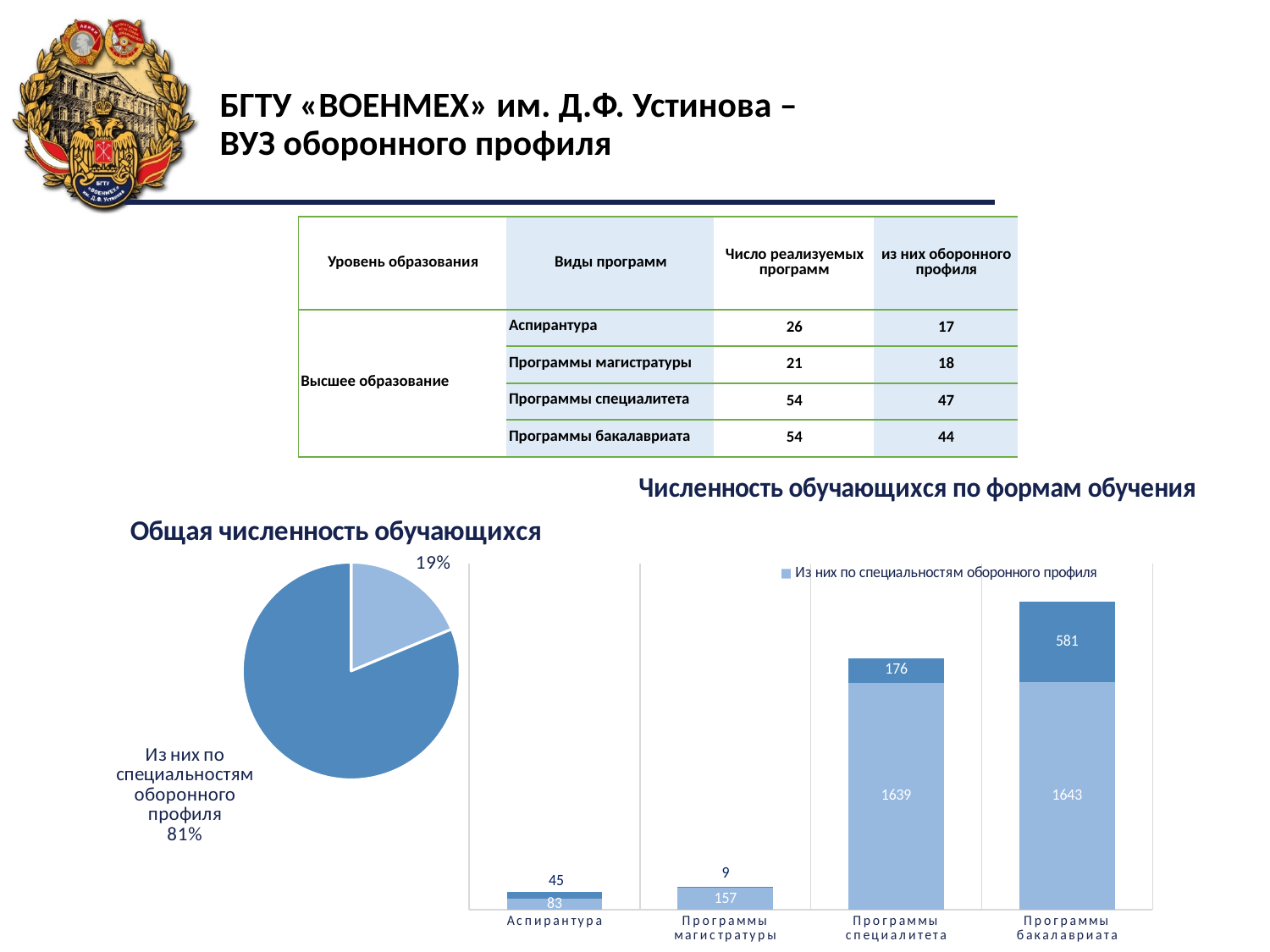
In the chart titled «Численность обучающихся по формам обучения», which category has the shortest stacked bar? Аспирантура In the chart titled «Численность обучающихся по формам обучения», what is the total of the stacked bar for Программы бакалавриата? 2224 In the chart titled «Численность обучающихся по формам обучения», which category has the tallest stacked bar? Программы бакалавриата In the chart titled «Численность обучающихся по формам обучения», what is the value of the dark-blue segment for Программы магистратуры? 9 In the chart titled «Численность обучающихся по формам обучения», what is the total of the stacked bar for Аспирантура? 128 In the pie chart titled «Общая численность обучающихся», what share is labelled «Из них по специальностям оборонного профиля»? 81% In the chart titled «Численность обучающихся по формам обучения», how many categories are shown on the x axis? 4 In the chart titled «Численность обучающихся по формам обучения», what is the difference between the dark-blue values for Программы бакалавриата and Программы специалитета? 405 In the pie chart titled «Общая численность обучающихся», what is the share of the smaller slice? 19% In the chart titled «Численность обучающихся по формам обучения», what is the value of the light-blue segment for Программы бакалавриата? 1643 In the chart titled «Численность обучающихся по формам обучения», what is the value of the dark-blue segment for Программы специалитета? 176 What kind of chart is «Численность обучающихся по формам обучения»? Stacked bar chart